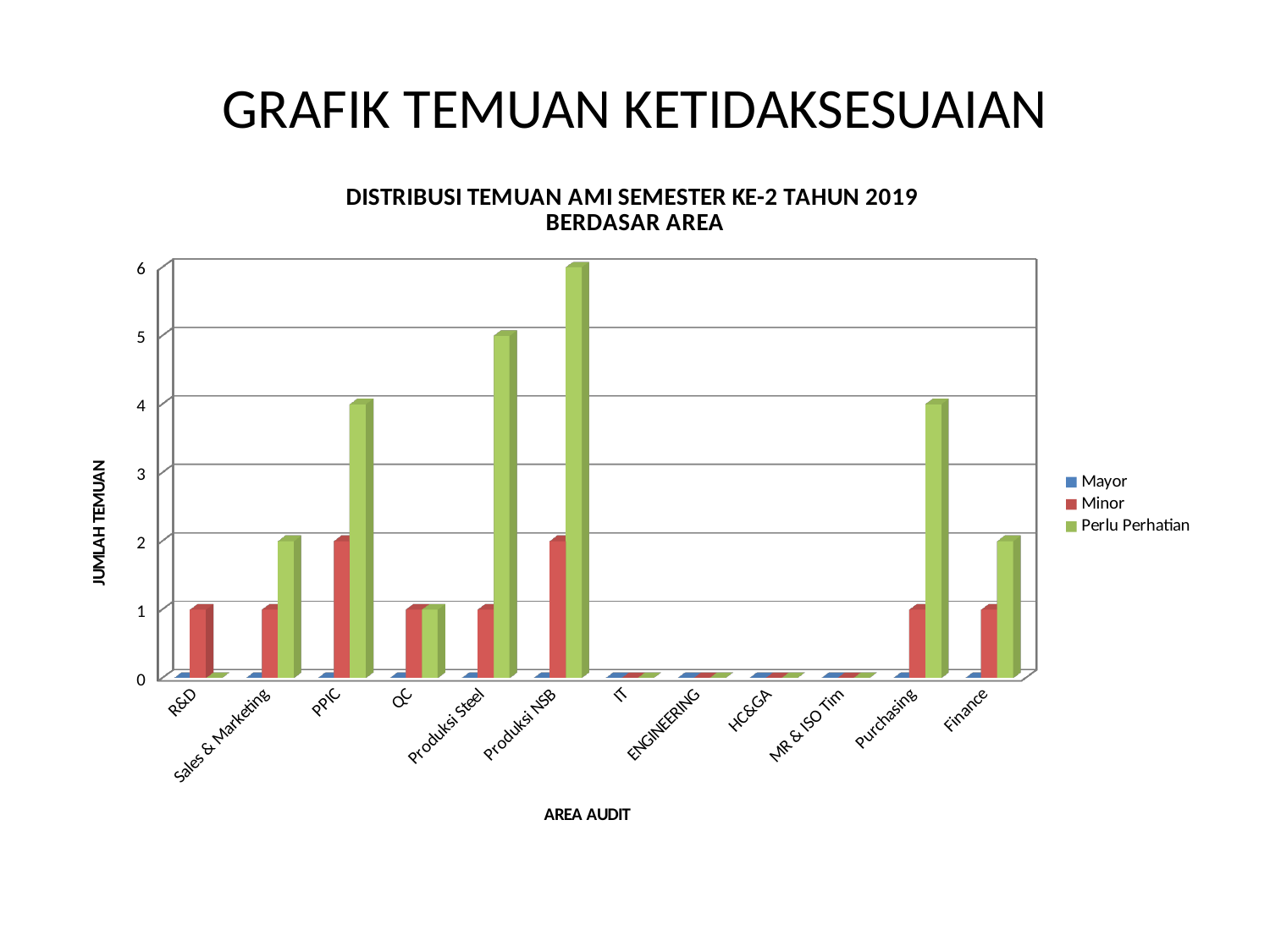
What is the Perlu Perhatian value for Produksi Steel? 5 What is the label of the vertical axis? JUMLAH TEMUAN What is the Minor value for PPIC? 2 What kind of chart is shown on the slide? bar chart What is the title of the chart? DISTRIBUSI TEMUAN AMI SEMESTER KE-2 TAHUN 2019 BERDASAR AREA What is the difference between the Perlu Perhatian values for Produksi NSB and PPIC? 2 What is the Perlu Perhatian value for Produksi NSB? 6 How many series does the legend list? 3 Is the Perlu Perhatian value for Purchasing greater or less than 3? greater Which audit area has the highest Perlu Perhatian value? Produksi NSB Which is larger for Sales & Marketing, the Minor value or the Perlu Perhatian value? Perlu Perhatian How many audit areas are shown on the x axis? 12